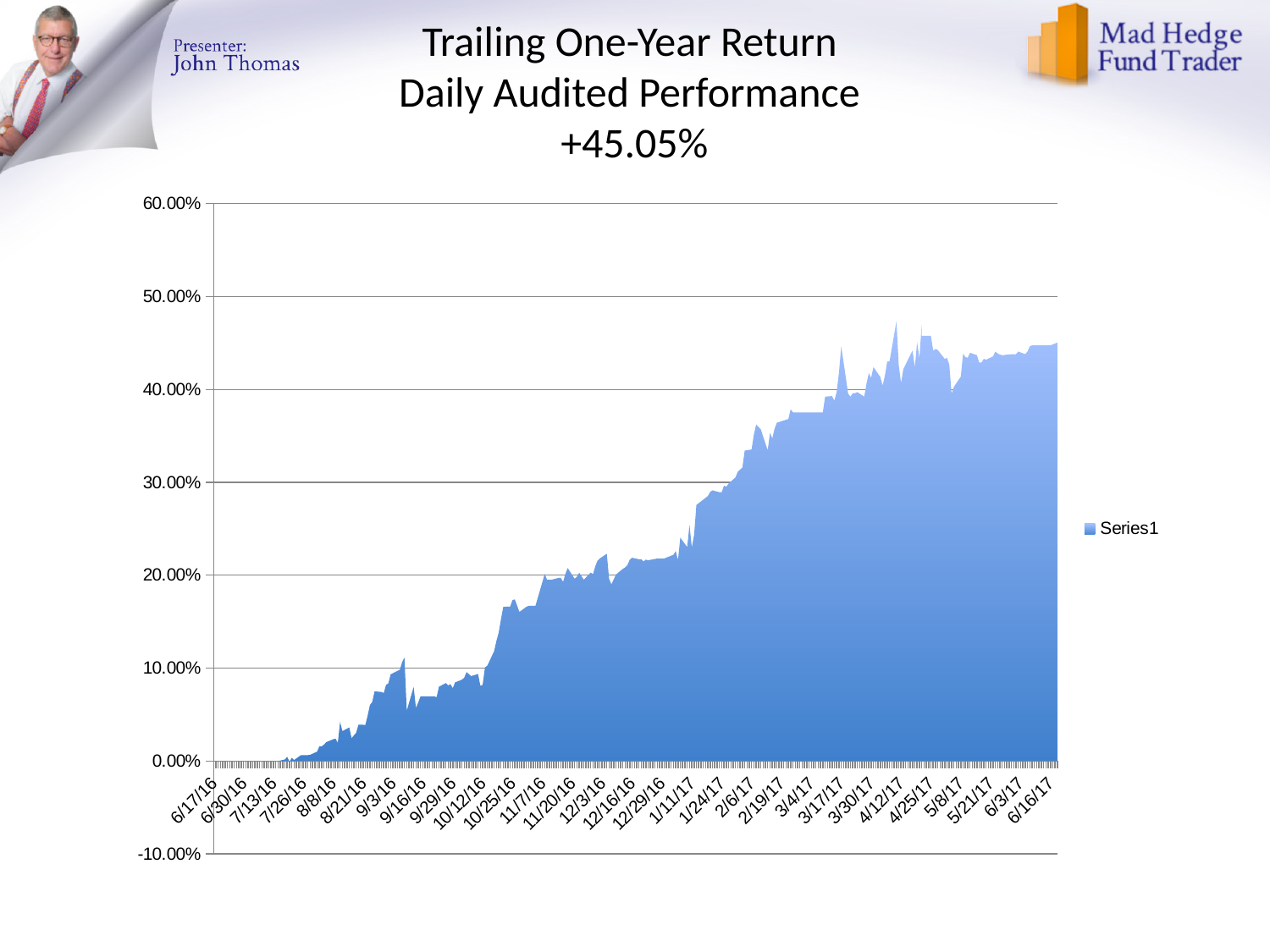
How many series does the legend list? 1 Do the values generally rise or fall from 6/17/16 to 6/16/17? rise Is the value for 10/12/16 greater or less than 20.00%? less Which of the two dates has the larger value, 9/16/16 or 3/17/17? 3/17/17 What is the legend entry for the plotted series? Series1 What trailing one-year return figure is printed in the slide title? +45.05% What is the highest tick label shown on the vertical axis? 60.00% Is the value for 2/19/17 greater or less than 30.00%? greater Is the value for 8/8/16 greater or less than 10.00%? less What kind of chart is shown on the slide? area chart